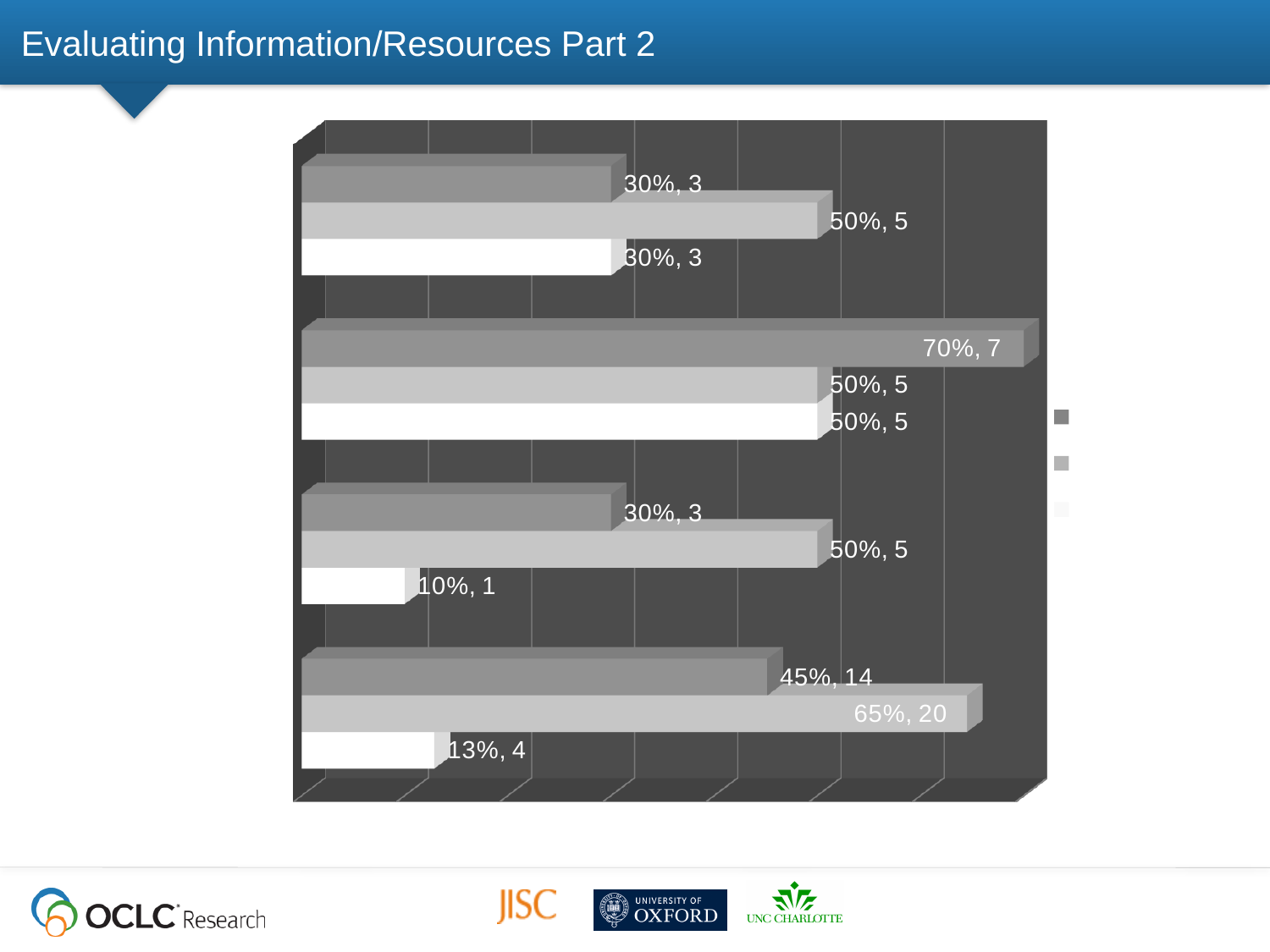
What kind of chart is shown on the slide? bar chart What is the data label on the dark grey bar in the second group from the top? 70%, 7 What is the data label on the white bar in the bottom group? 13%, 4 In the second group from the top, which is larger: the dark grey bar or the light grey bar? the dark grey bar In the bottom group, what is the difference in percentage between the light grey bar and the dark grey bar? 20 percentage points How many series does the legend list? 3 Which bar has the lowest percentage in the chart? the white bar in the third group from the top (10%) How many groups of bars does the chart contain? 4 What is the title of the slide containing the chart? Evaluating Information/Resources Part 2 What is the data label on the light grey bar in the bottom group? 65%, 20 What is the data label on the light grey bar in the top group? 50%, 5 Which bar has the highest percentage in the chart? the dark grey bar in the second group from the top (70%)